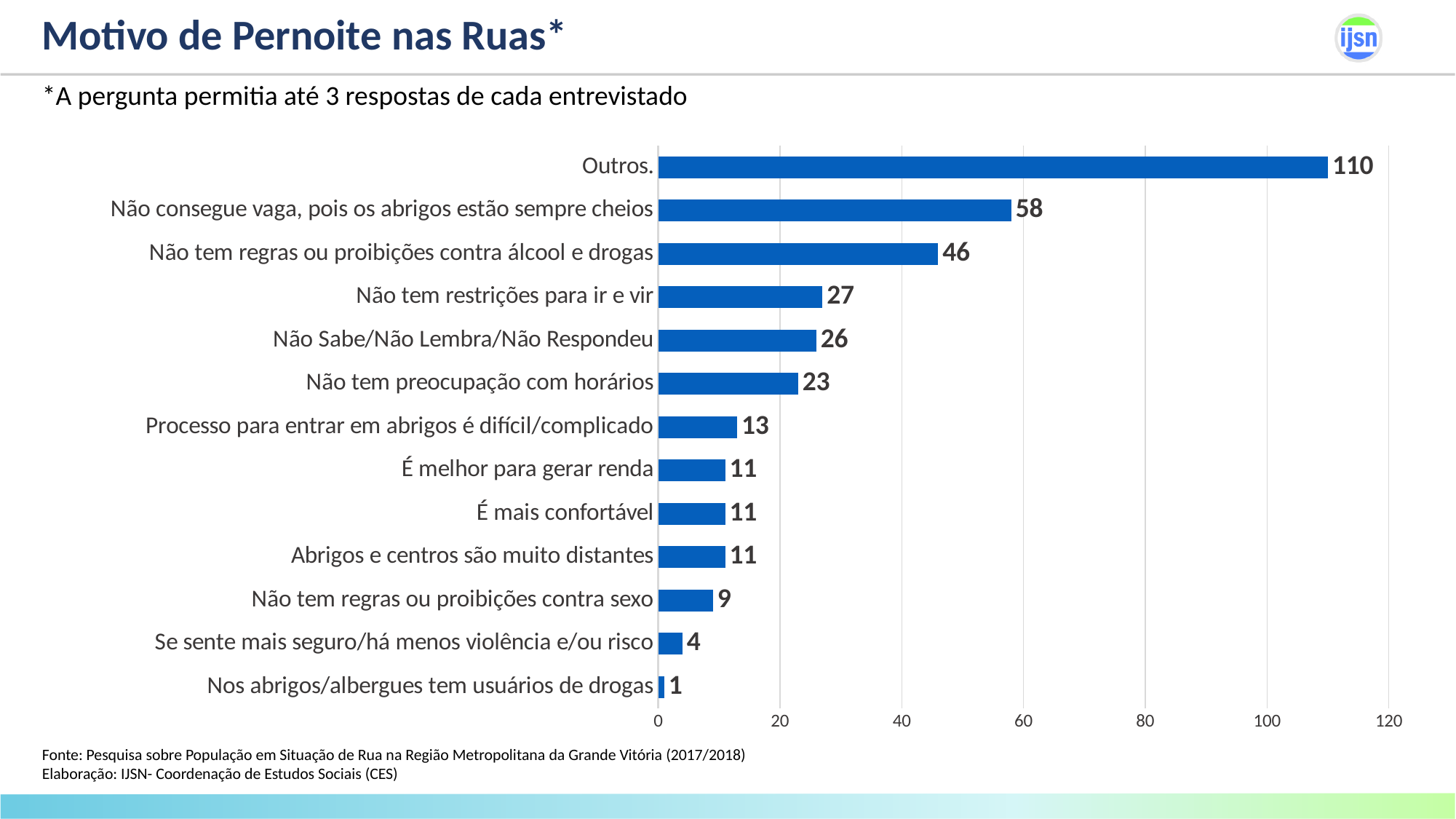
What is the title of the slide? Motivo de Pernoite nas Ruas* Which is larger: the value for "Processo para entrar em abrigos é difícil/complicado" or the value for "Não tem regras ou proibições contra sexo"? Processo para entrar em abrigos é difícil/complicado What is the value for "Se sente mais seguro/há menos violência e/ou risco"? 4 What kind of chart is shown on the slide? Bar chart How many categories are shown in the chart? 13 Which category has the highest value? Outros. Is the value for "Não tem regras ou proibições contra álcool e drogas" greater or less than 40? greater What is the value for "Não tem restrições para ir e vir"? 27 Which category has the lowest value? Nos abrigos/albergues tem usuários de drogas What is the difference between the values for "Outros." and "Não consegue vaga, pois os abrigos estão sempre cheios"? 52 What is the difference between the values for "Não tem regras ou proibições contra álcool e drogas" and "Não tem preocupação com horários"? 23 What is the value for "Não consegue vaga, pois os abrigos estão sempre cheios"? 58